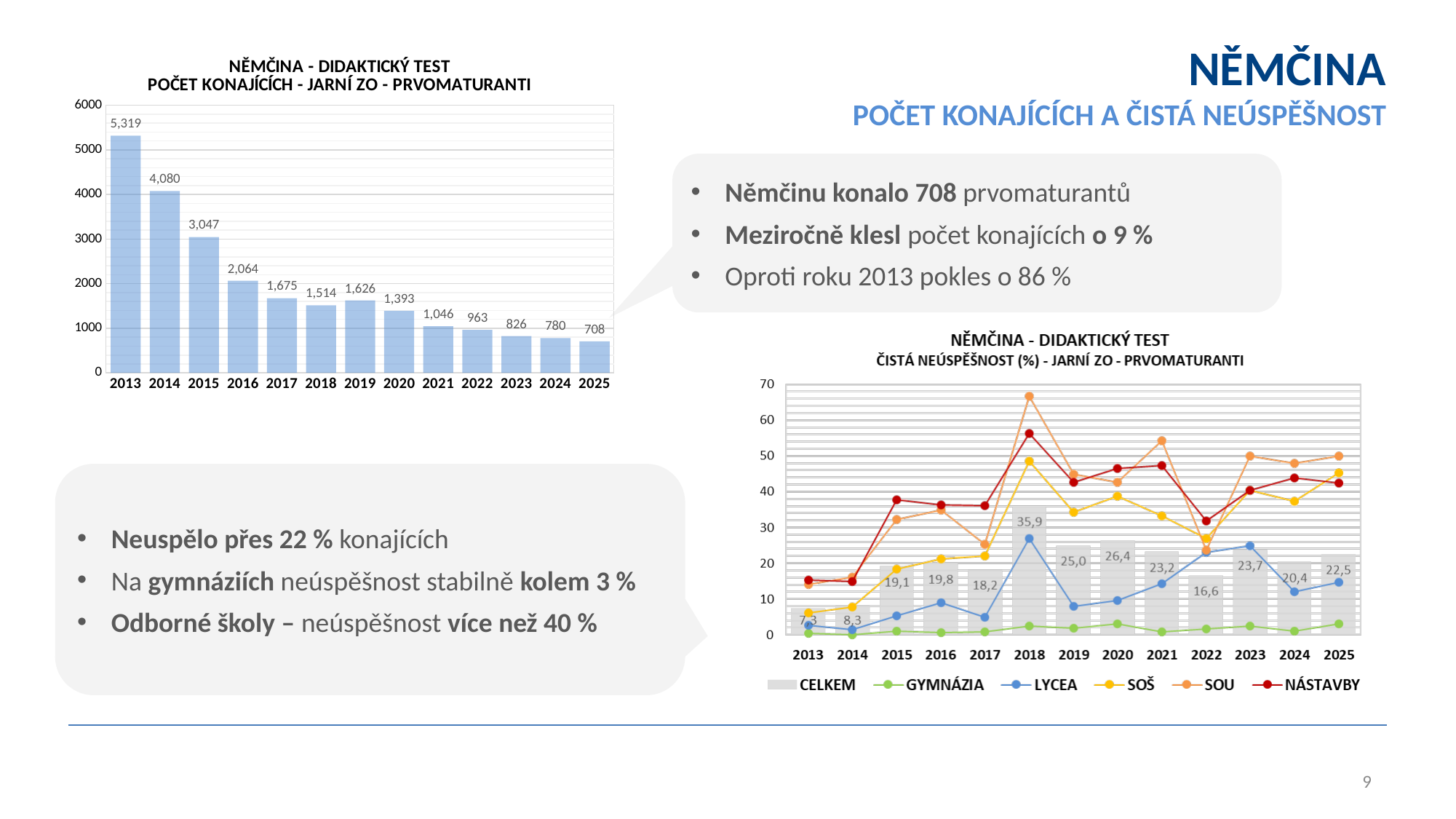
In the chart 'POČET KONAJÍCÍCH - JARNÍ ZO - PRVOMATURANTI' (left), how many years are shown on the x axis? 13 In the chart 'POČET KONAJÍCÍCH - JARNÍ ZO - PRVOMATURANTI' (left), which is larger, the value for 2018 or the value for 2019? 2019 In the chart 'ČISTÁ NEÚSPĚŠNOST (%) - JARNÍ ZO - PRVOMATURANTI' (right), how many series does the legend list? 6 In the chart 'POČET KONAJÍCÍCH - JARNÍ ZO - PRVOMATURANTI' (left), which year has the lowest value? 2025 In the chart 'ČISTÁ NEÚSPĚŠNOST (%) - JARNÍ ZO - PRVOMATURANTI' (right), which year has the highest CELKEM value? 2018 In the chart 'ČISTÁ NEÚSPĚŠNOST (%) - JARNÍ ZO - PRVOMATURANTI' (right), is the SOU value for 2018 greater or less than 60? greater In the chart 'ČISTÁ NEÚSPĚŠNOST (%) - JARNÍ ZO - PRVOMATURANTI' (right), what is the CELKEM value for 2018? 35,9 In the chart 'POČET KONAJÍCÍCH - JARNÍ ZO - PRVOMATURANTI' (left), what is the value for 2013? 5,319 In the chart 'POČET KONAJÍCÍCH - JARNÍ ZO - PRVOMATURANTI' (left), what is the difference between the values for 2024 and 2025? 72 In the chart 'POČET KONAJÍCÍCH - JARNÍ ZO - PRVOMATURANTI' (left), do the values generally rise or fall from 2013 to 2025? Fall In the chart 'POČET KONAJÍCÍCH - JARNÍ ZO - PRVOMATURANTI' (left), what is the value for 2025? 708 What kind of chart is the left chart 'POČET KONAJÍCÍCH - JARNÍ ZO - PRVOMATURANTI'? Bar chart